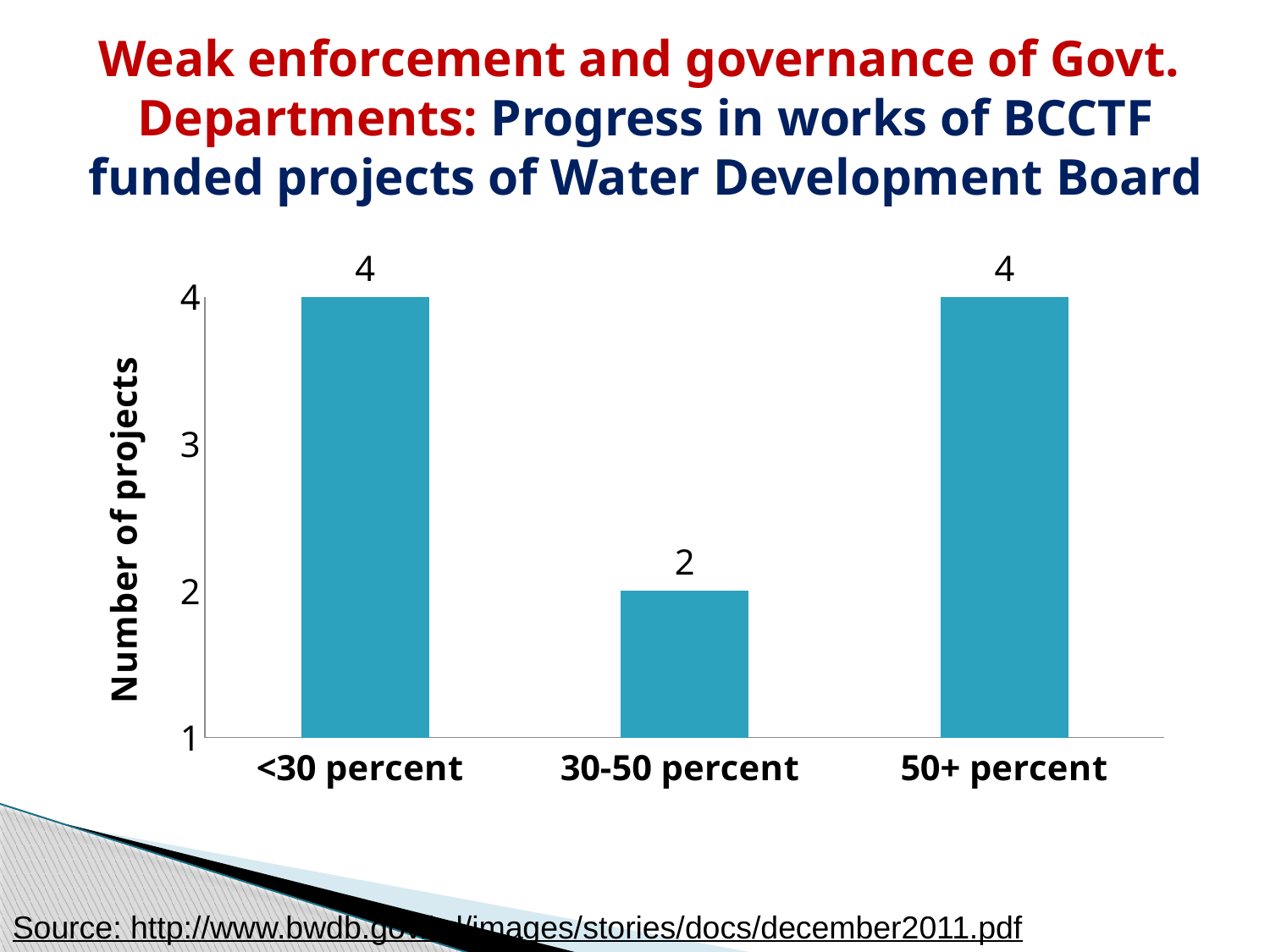
What kind of chart is shown on the slide? Bar chart Do the <30 percent and 50+ percent categories have the same number of projects? Yes What is the label of the vertical axis? Number of projects How many projects are in the <30 percent category? 4 How many categories are shown on the x axis? 3 Is the value for 30-50 percent greater or less than 3? less Which has more projects, the 30-50 percent category or the 50+ percent category? 50+ percent What is the difference in number of projects between the <30 percent and 30-50 percent categories? 2 Which category has the lowest number of projects? 30-50 percent How many projects are in the 50+ percent category? 4 What is the total number of projects across all three categories? 10 How many projects are in the 30-50 percent category? 2